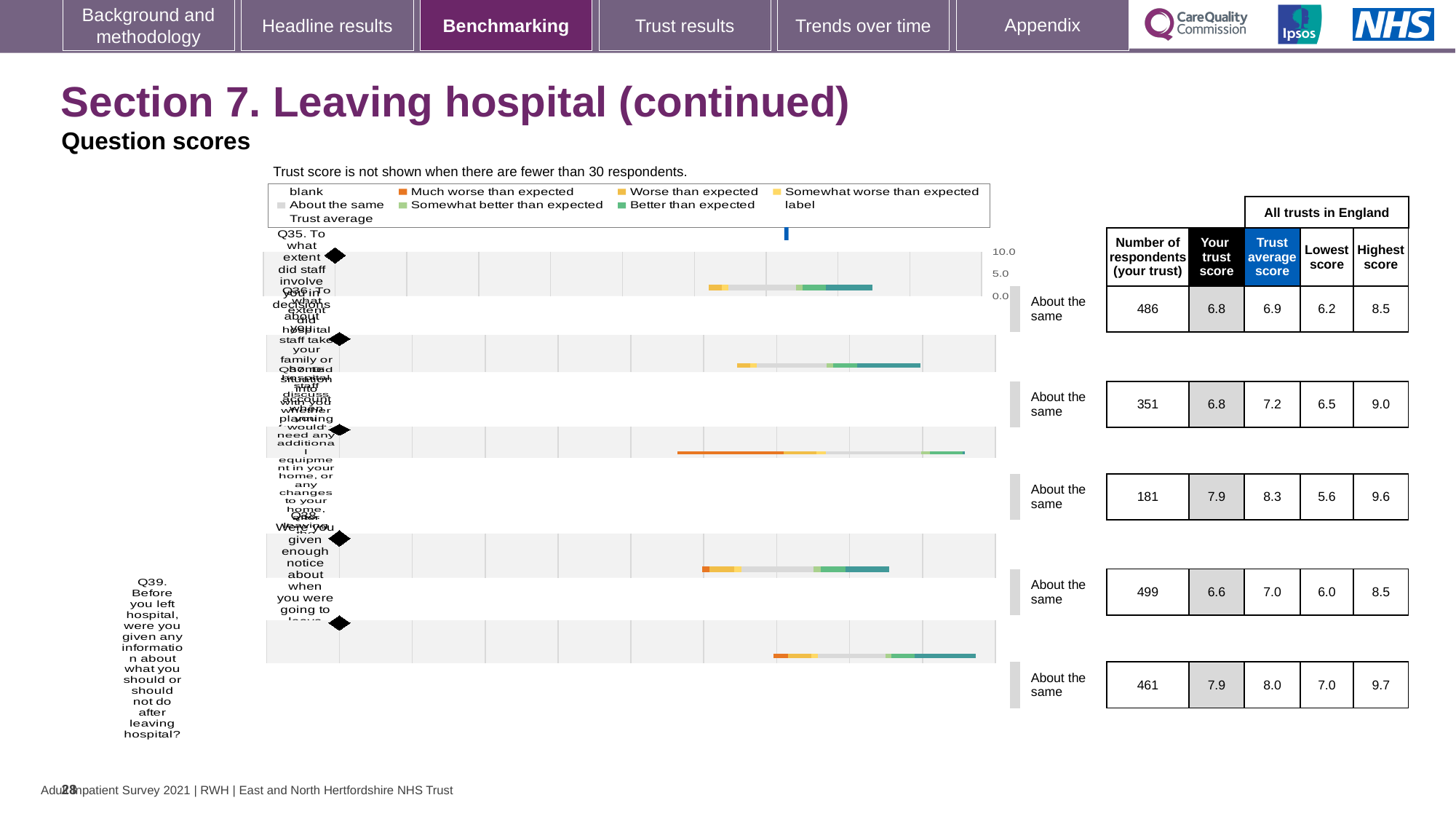
For Q38, which is larger: your trust score or the trust average score? Trust average score What benchmark category is shown for Q39? About the same How many questions (rows) are plotted in the question scores chart? 5 For Q35, what is the difference between the trust average score and your trust score? 0.1 Which question has the highest value in the 'Highest score' column? Q39 Which question has the lowest value in the 'Lowest score' column? Q37 How many respondents (your trust) are shown for Q38? 499 What is the 'Your trust score' for Q39 (information about what you should or should not do after leaving hospital)? 7.9 What is the title of the slide containing the question scores chart? Section 7. Leaving hospital (continued) Is the trust score marker for Q39 greater or less than 5.0 on the axis? greater What kind of chart is used to show the question scores on this slide? bar chart How many respondents (your trust) are shown for Q35? 486